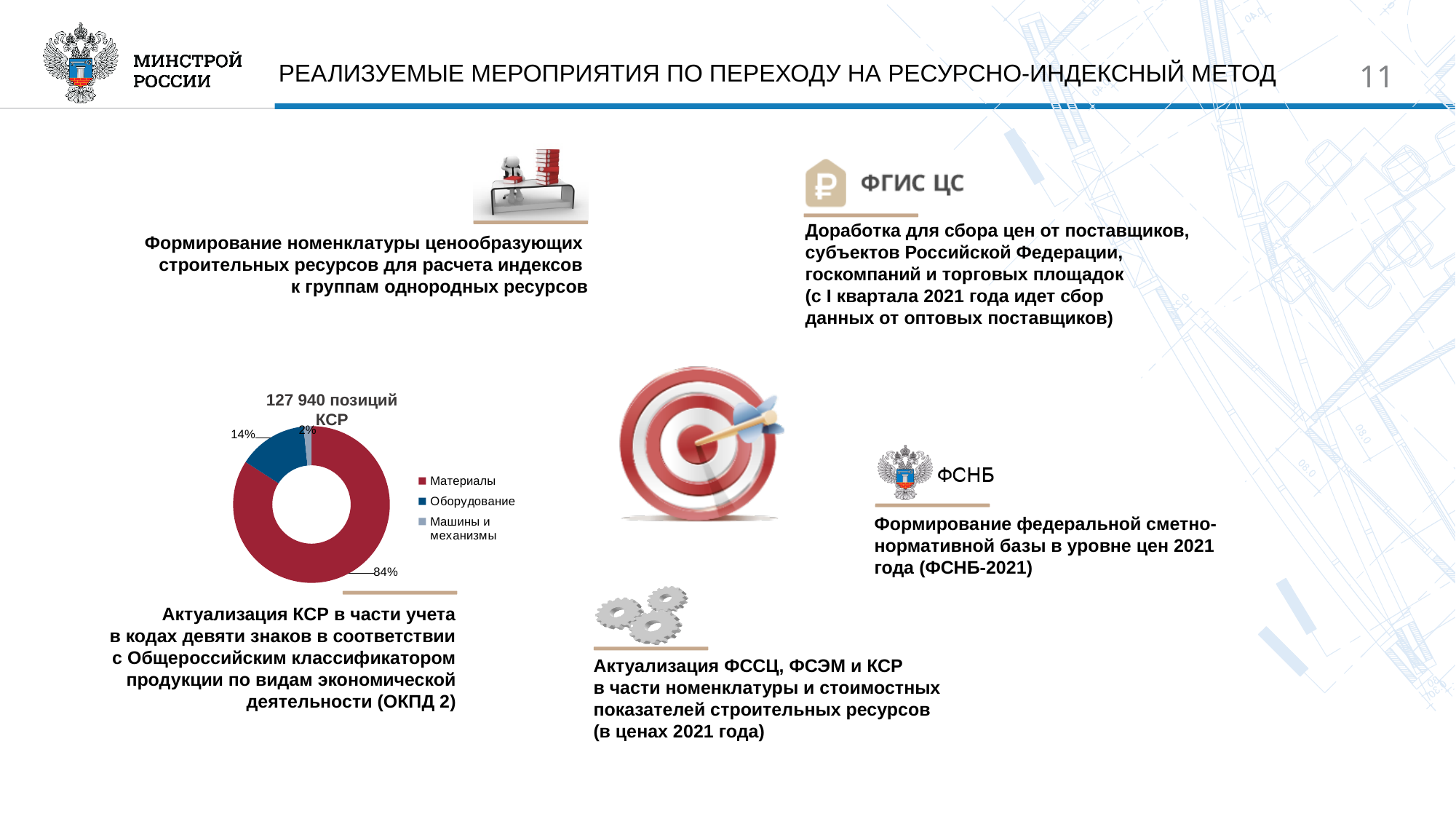
What is the title of the doughnut chart? 127 940 позиций КСР What type of chart is shown on the slide? Doughnut chart What is the difference in percentage points between Оборудование and Машины и механизмы? 12 How many categories does the doughnut chart show? 3 Which is larger in the doughnut chart, Оборудование or Машины и механизмы? Оборудование What share of the doughnut chart is Машины и механизмы? 2% What share of the doughnut chart is Оборудование? 14% Which category has the smallest share in the doughnut chart? Машины и механизмы What colour represents Материалы in the doughnut chart? Red What share of the doughnut chart is Материалы? 84% Which category has the largest share in the doughnut chart? Материалы What is the difference in percentage points between Материалы and Оборудование? 70